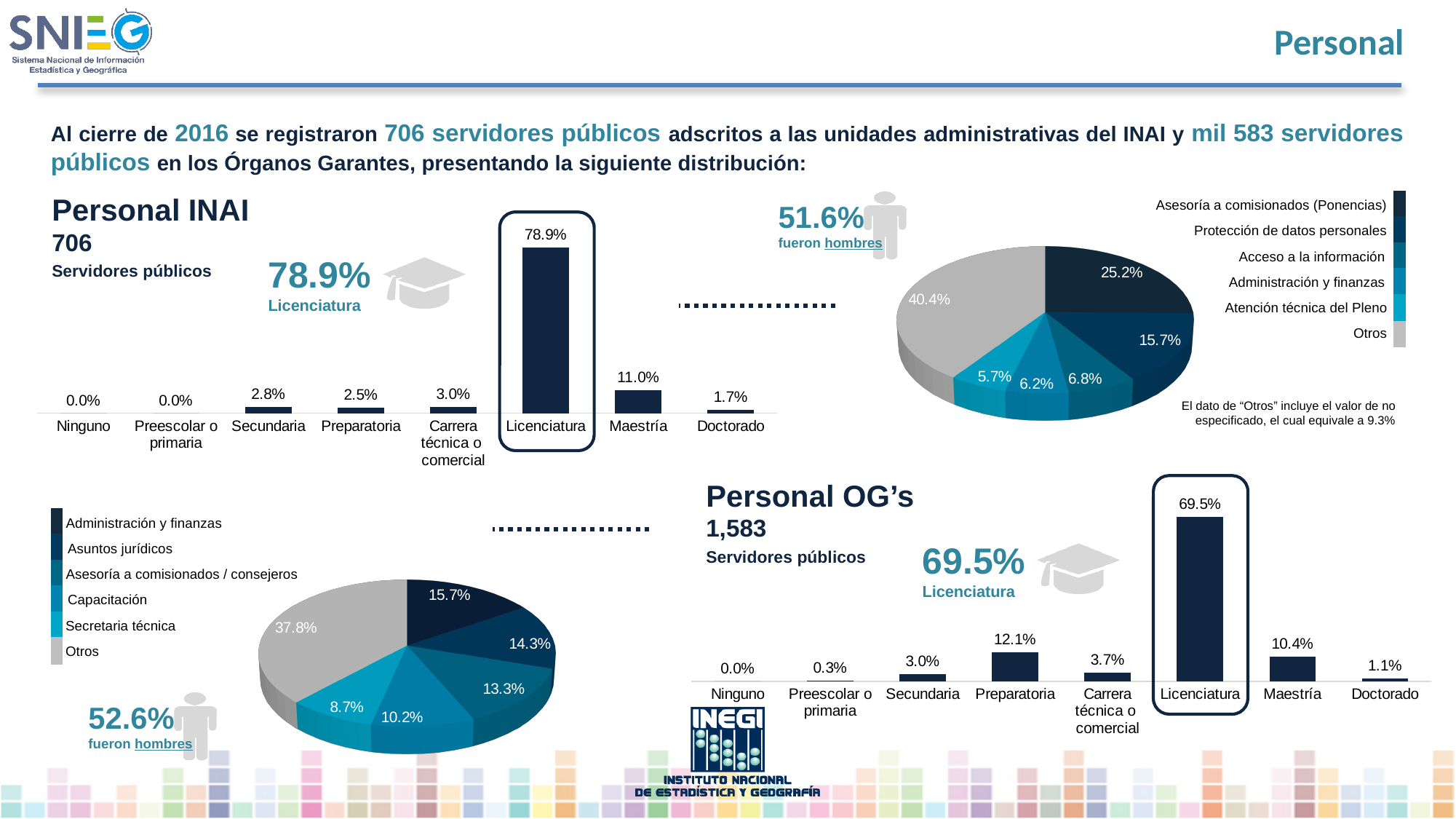
In the Personal OG's bar chart, what percentage is shown for Preescolar o primaria? 0.3% How many entries does the legend of the Personal OG's pie chart (bottom left) list? 6 In the Personal INAI bar chart, what percentage is shown for Maestría? 11.0% In the Personal INAI bar chart, how many education categories are shown on the x axis? 8 In the Personal OG's bar chart, which is larger, the value for Preparatoria or the value for Maestría? Preparatoria In the pie chart for Personal OG's (bottom left), what share is shown for the Otros slice? 37.8% In the Personal INAI bar chart, what is the difference between the Maestría and Doctorado values? 9.3% In the pie chart for Personal INAI (top right), what share is shown for the Otros slice? 40.4% In the Personal OG's bar chart, what is the difference between the Licenciatura and Maestría values? 59.1% In the Personal INAI bar chart, which category has the highest value? Licenciatura In the Personal INAI bar chart, what percentage is shown for Licenciatura? 78.9% In the Personal OG's bar chart, what percentage is shown for Preparatoria? 12.1%